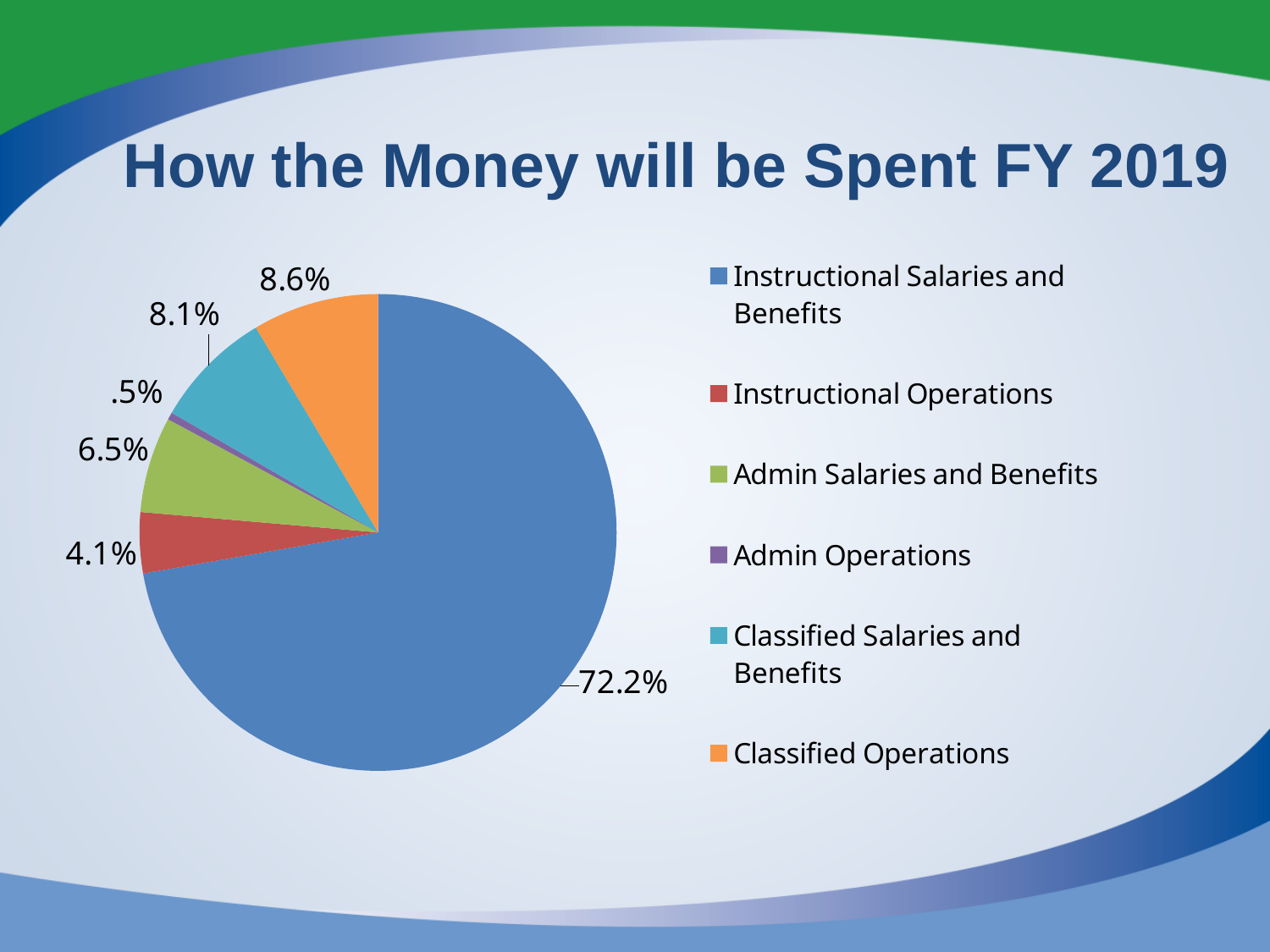
What percentage is shown for Instructional Operations? 4.1% Which is larger, Classified Salaries and Benefits or Admin Salaries and Benefits? Classified Salaries and Benefits What share of the pie is Instructional Salaries and Benefits? 72.2% What percentage is shown for Classified Operations? 8.6% What kind of chart is shown on the slide? Pie chart Which category has the smallest slice of the pie? Admin Operations What is the difference in percentage points between Classified Operations and Classified Salaries and Benefits? 0.5 What is the title of the slide? How the Money will be Spent FY 2019 Which category has the largest slice of the pie? Instructional Salaries and Benefits What percentage is shown for Admin Operations? .5% How many categories does the pie chart show? 6 What percentage is shown for Admin Salaries and Benefits? 6.5%